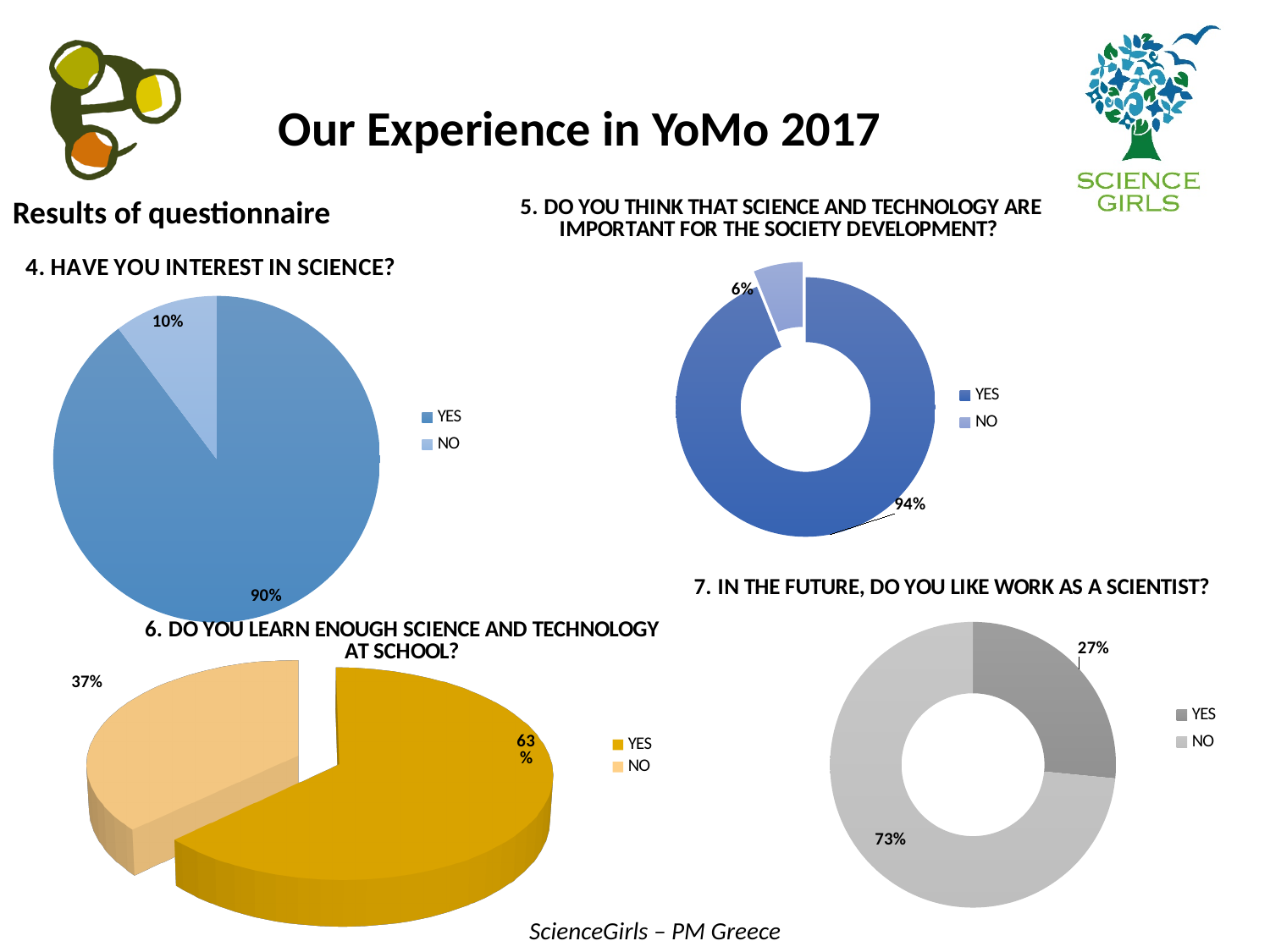
How many categories does the legend of the chart '4. HAVE YOU INTEREST IN SCIENCE?' list? 2 In the chart '4. HAVE YOU INTEREST IN SCIENCE?', what share of respondents answered NO? 10% In the chart '6. DO YOU LEARN ENOUGH SCIENCE AND TECHNOLOGY AT SCHOOL?', what is the difference between the YES and NO shares? 26% In the chart '5. DO YOU THINK THAT SCIENCE AND TECHNOLOGY ARE IMPORTANT FOR THE SOCIETY DEVELOPMENT?', what percentage answered NO? 6% In the chart '7. IN THE FUTURE, DO YOU LIKE WORK AS A SCIENTIST?', which answer has the larger share, YES or NO? NO In the chart '7. IN THE FUTURE, DO YOU LIKE WORK AS A SCIENTIST?', what percentage answered NO? 73% In the chart '5. DO YOU THINK THAT SCIENCE AND TECHNOLOGY ARE IMPORTANT FOR THE SOCIETY DEVELOPMENT?', which answer has the smallest share? NO In the chart '5. DO YOU THINK THAT SCIENCE AND TECHNOLOGY ARE IMPORTANT FOR THE SOCIETY DEVELOPMENT?', what percentage answered YES? 94% In the chart '4. HAVE YOU INTEREST IN SCIENCE?', what is the difference between the YES and NO shares? 80% In the chart '4. HAVE YOU INTEREST IN SCIENCE?', what share of respondents answered YES? 90% What kind of chart is '6. DO YOU LEARN ENOUGH SCIENCE AND TECHNOLOGY AT SCHOOL?'? Pie chart In the chart '6. DO YOU LEARN ENOUGH SCIENCE AND TECHNOLOGY AT SCHOOL?', what share answered YES? 63%